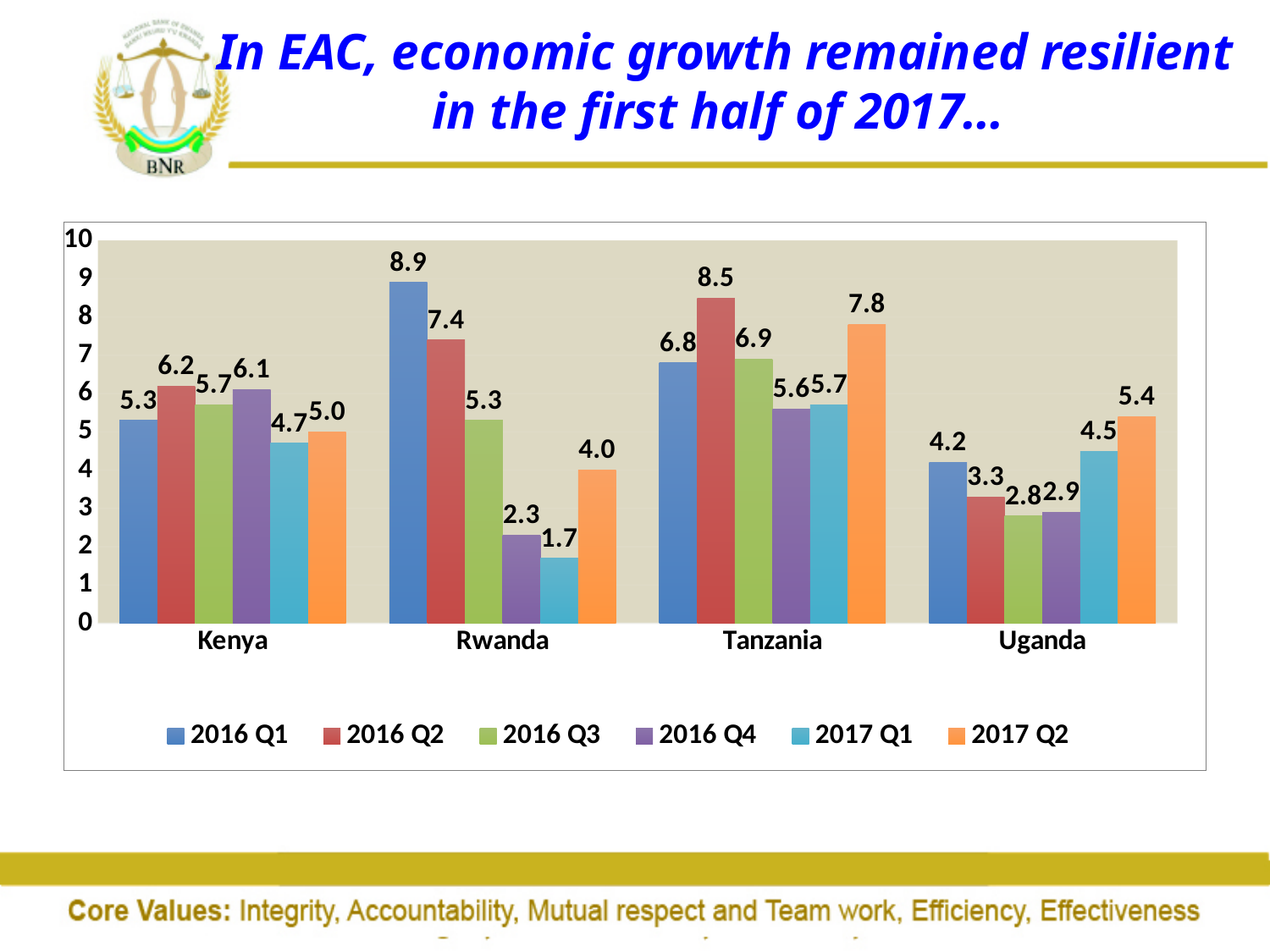
What kind of chart is shown on the slide? Bar chart How many countries are shown on the x axis? 4 What is the value for Rwanda in 2016 Q1? 8.9 What is the value for Tanzania in 2016 Q2? 8.5 What is the value for Kenya in 2017 Q1? 4.7 Which country has the highest value in 2017 Q2? Tanzania How many series does the legend list? 6 What is the value for Uganda in 2017 Q2? 5.4 Is the value for Tanzania in 2016 Q2 greater or less than 8? greater Which country has the lowest value in 2017 Q1? Rwanda What is the difference between Rwanda's 2016 Q1 value and its 2017 Q1 value? 7.2 Which is larger: Kenya's 2016 Q4 value or Uganda's 2016 Q4 value? Kenya's 2016 Q4 value